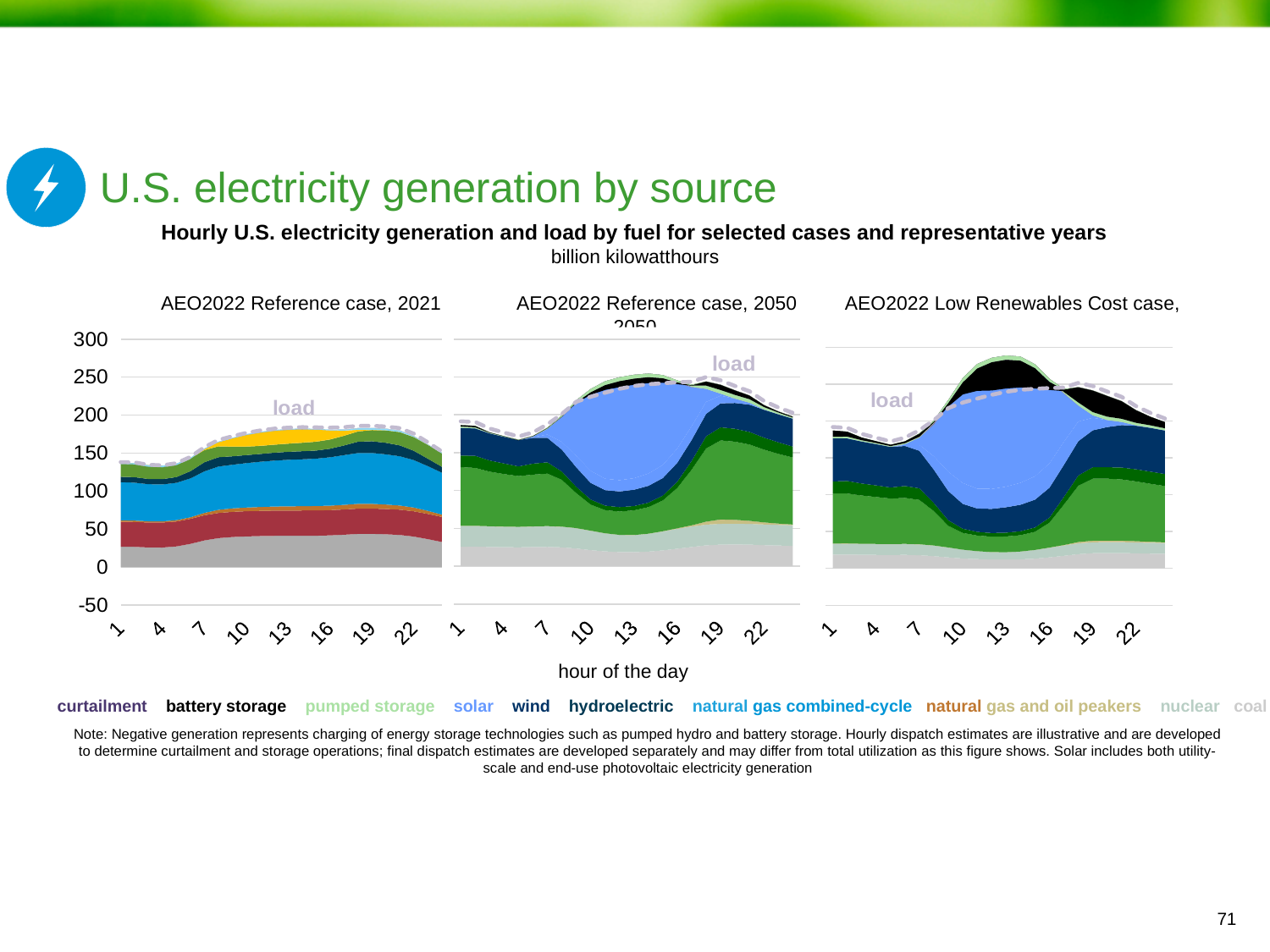
In the AEO2022 Reference case, 2021 chart, is the load at hour 13 greater or less than 200? less How many chart panels are shown on the slide? 3 In the AEO2022 Reference case, 2021 chart, is the load at hour 13 greater or less than 150? greater In the AEO2022 Low Renewables Cost case, 2050 chart, is the total generation at hour 13 greater or less than 250? greater How many series does the legend list? 10 What is the label of the x axis shared by the three charts? hour of the day What unit is given for the y axis of the charts? billion kilowatthours What kind of chart is used in each of the three panels on the slide? stacked area chart In the AEO2022 Reference case, 2021 chart, does the load rise or fall from hour 1 to hour 13? rise